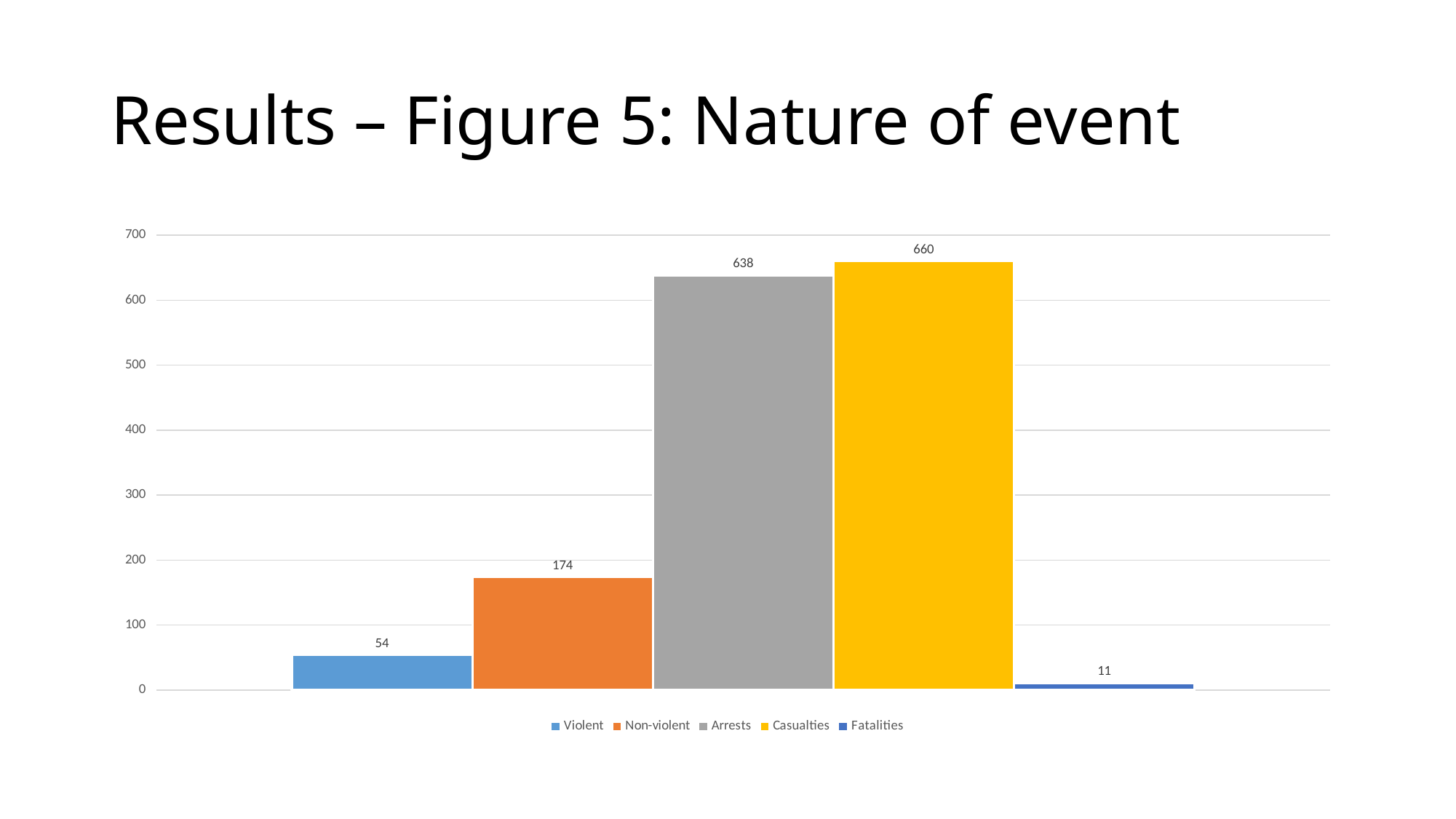
Which series has the highest value? Casualties What colour is the Casualties bar? Yellow Is the value for Arrests greater or less than 600? greater What is the value for Fatalities? 11 How many series does the legend list? 5 What kind of chart is shown on the slide? Bar chart What is the value for Non-violent? 174 What is the difference between the Casualties and Arrests values? 22 Which series has the lowest value? Fatalities Which is larger, the value for Violent or the value for Non-violent? Non-violent What is the difference between the Non-violent and Violent values? 120 What is the value for Arrests? 638